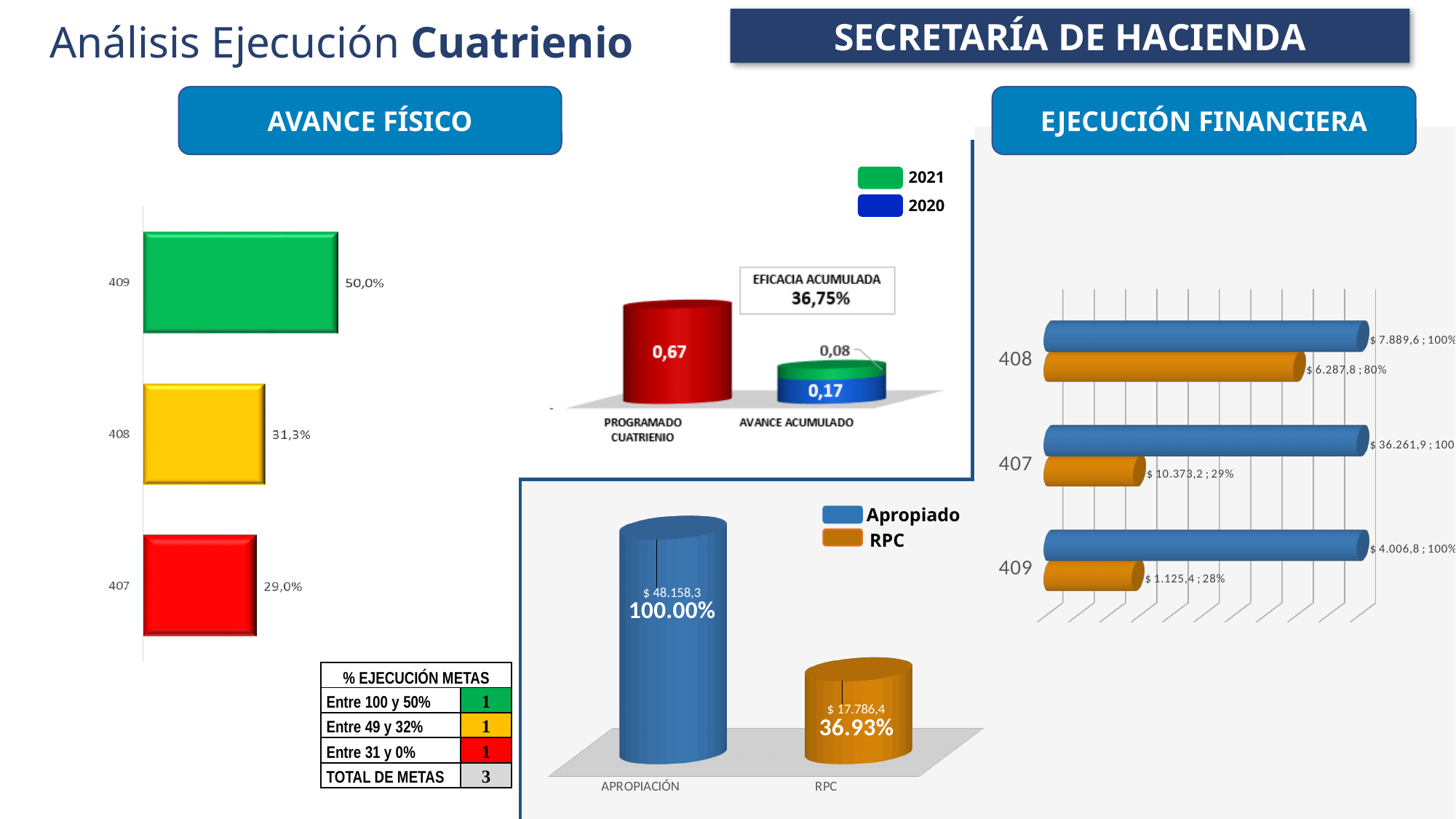
In the top-middle chart with PROGRAMADO CUATRIENIO and AVANCE ACUMULADO, what is the 2020 value for AVANCE ACUMULADO? 0,17 In the AVANCE FÍSICO bar chart on the left, which category has the lowest value? 407 In the top-middle chart with PROGRAMADO CUATRIENIO and AVANCE ACUMULADO, what is the value for PROGRAMADO CUATRIENIO? 0,67 In the bottom-middle chart with APROPIACIÓN and RPC, what percentage is shown for RPC? 36.93% In the AVANCE FÍSICO bar chart on the left, what is the value for category 409? 50,0% What kind of chart is the EJECUCIÓN FINANCIERA chart on the right? bar chart In the top-middle chart with PROGRAMADO CUATRIENIO and AVANCE ACUMULADO, how many series does the legend list? 2 In the AVANCE FÍSICO bar chart on the left, what is the difference between the values for 409 and 408? 18,7% In the EJECUCIÓN FINANCIERA chart on the right, what is the RPC value for category 407? $ 10.373,2 ; 29% In the EJECUCIÓN FINANCIERA chart on the right, which category has the highest Apropiado value? 407 In the AVANCE FÍSICO bar chart on the left, how many categories are plotted? 3 In the bottom-middle chart with APROPIACIÓN and RPC, what amount is shown for APROPIACIÓN? $ 48.158,3